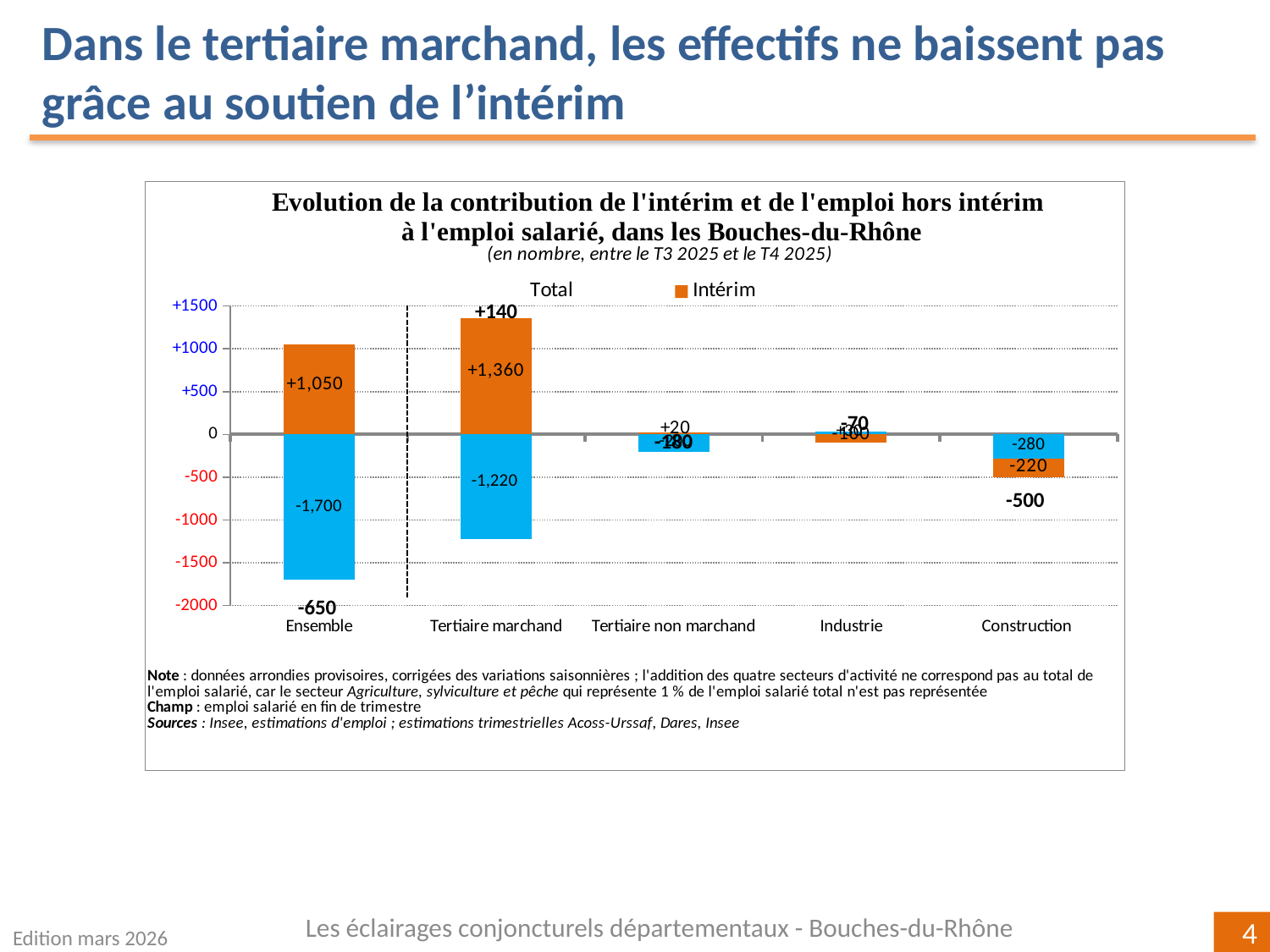
Which is larger, the Intérim value for Ensemble or for Tertiaire marchand? Tertiaire marchand What is the value of the blue bar for Ensemble? -1,700 What is the difference between the Intérim values for Tertiaire marchand and Ensemble? 310 What is the Total value for Ensemble? -650 What is the Intérim value for Construction? -220 Which category has the highest Intérim value? Tertiaire marchand What is the Intérim value for Tertiaire marchand? +1,360 What kind of chart is shown on the slide? Bar chart How many sector categories are shown on the x axis? 5 What is the Total value for Tertiaire marchand? +140 What is the Total value for Construction? -500 What is the Intérim value for Ensemble? +1,050